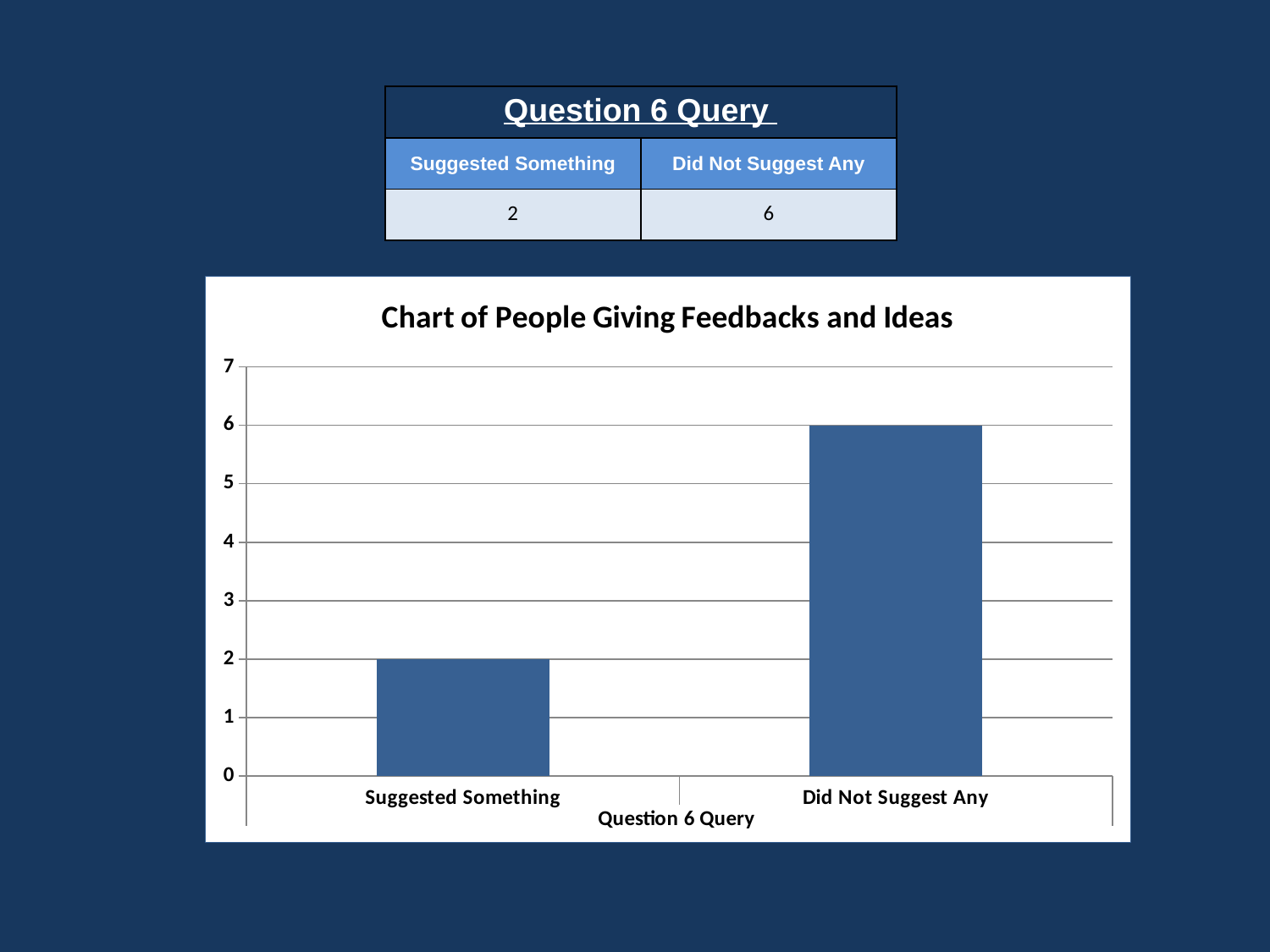
What is the value for Suggested Something? 2 Which category has the lowest value? Suggested Something Which is larger, the value for Suggested Something or the value for Did Not Suggest Any? Did Not Suggest Any What kind of chart is shown on the slide? bar chart What is the label of the x axis? Question 6 Query What is the value for Did Not Suggest Any? 6 Is the value for Did Not Suggest Any greater or less than 5? greater Is the value for Suggested Something greater or less than 3? less How many categories are shown on the x axis? 2 What is the title of the chart? Chart of People Giving Feedbacks and Ideas What is the difference between the values for Did Not Suggest Any and Suggested Something? 4 Which category has the highest value? Did Not Suggest Any